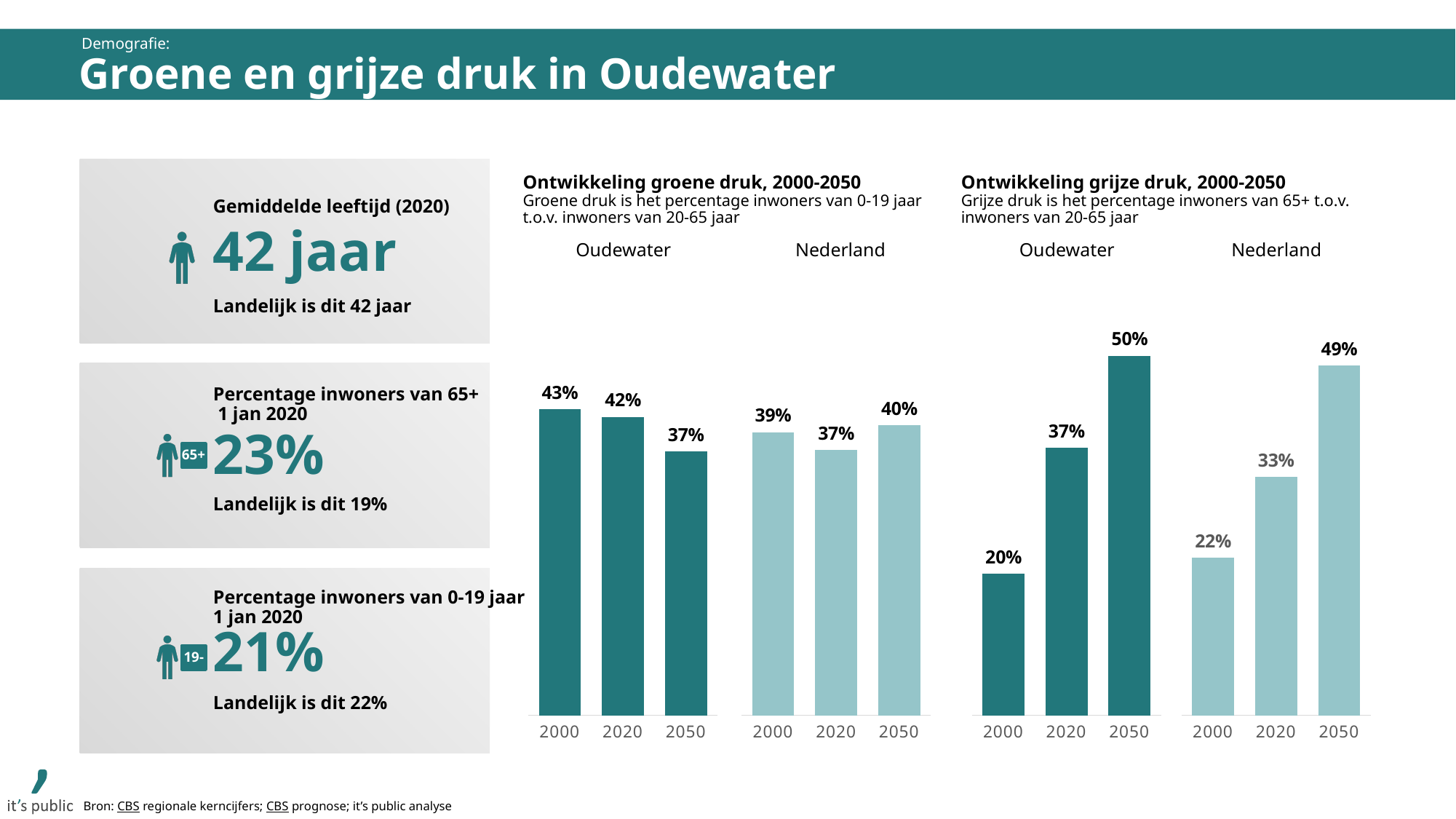
In the 'Ontwikkeling grijze druk, 2000-2050' chart, what is the value for Oudewater in 2020? 37% In the 'Ontwikkeling grijze druk, 2000-2050' chart, what is the value for Nederland in 2000? 22% In the 'Ontwikkeling groene druk, 2000-2050' chart, what is the value for Oudewater in 2000? 43% How many bars are shown in the 'Ontwikkeling grijze druk, 2000-2050' chart? 6 In the 'Ontwikkeling grijze druk, 2000-2050' chart, which is larger in 2020: Oudewater or Nederland? Oudewater What kind of chart is 'Ontwikkeling groene druk, 2000-2050'? bar chart In the 'Ontwikkeling groene druk, 2000-2050' chart, which year has the lowest value for Oudewater? 2050 In the 'Ontwikkeling grijze druk, 2000-2050' chart, what is the difference between the Oudewater values for 2050 and 2000? 30% In the 'Ontwikkeling grijze druk, 2000-2050' chart, which bar has the highest value? Oudewater 2050 In the 'Ontwikkeling groene druk, 2000-2050' chart, what is the difference between Oudewater and Nederland in 2020? 5% In the 'Ontwikkeling grijze druk, 2000-2050' chart, do the Oudewater values rise or fall from 2000 to 2050? rise In the 'Ontwikkeling groene druk, 2000-2050' chart, what is the value for Nederland in 2050? 40%